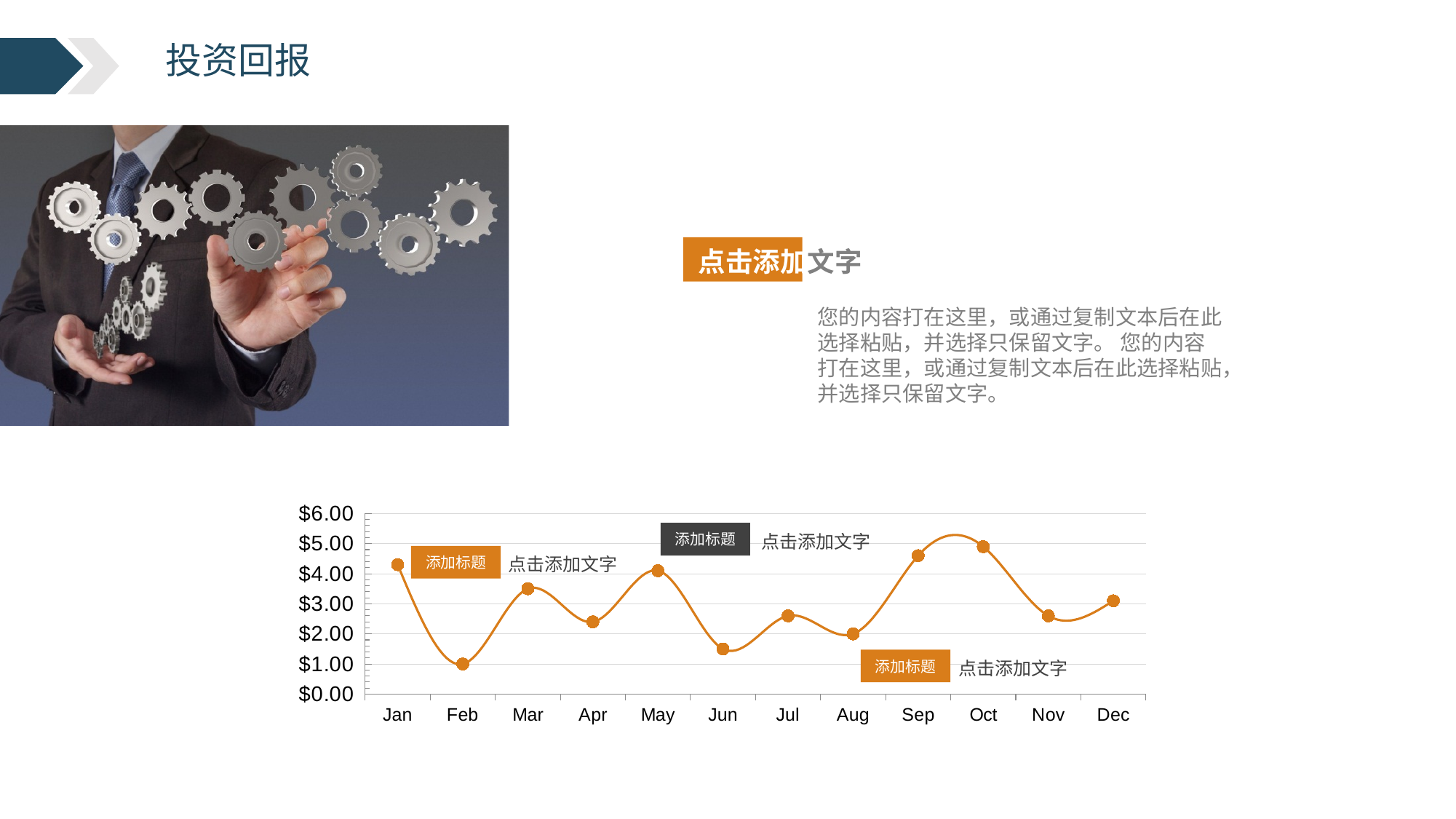
Is the value for Jan greater or less than $4.00? greater Which month has the lowest value in the chart? Feb Which is larger, the value for Jun or the value for Sep? Sep Is the value for Jun greater or less than $2.00? less Do the values rise or fall from Aug to Oct? rise What kind of chart is shown on the slide? line chart Is the value for Sep greater or less than $4.00? greater How many months are plotted on the x axis of the chart? 12 Which month has the highest value in the chart? Oct Which is larger, the value for Mar or the value for Apr? Mar